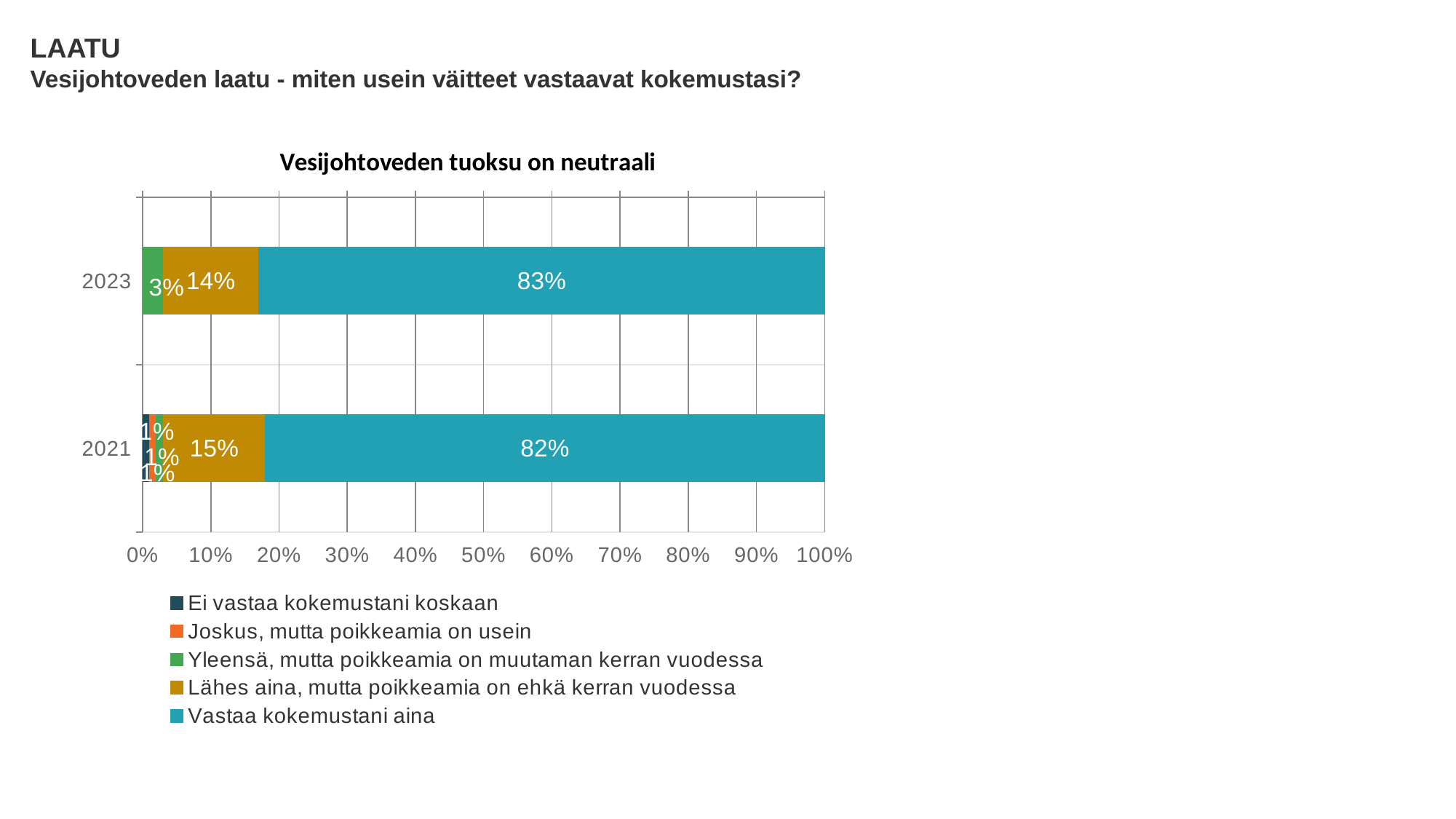
What kind of chart is shown on the slide? Stacked bar chart What is the value for "Lähes aina, mutta poikkeamia on ehkä kerran vuodessa" in 2021? 15% Which year has the larger value for "Lähes aina, mutta poikkeamia on ehkä kerran vuodessa", 2023 or 2021? 2021 How many categories (years) are shown on the chart? 2 What is the value for "Yleensä, mutta poikkeamia on muutaman kerran vuodessa" in 2023? 3% What is the title of the chart? Vesijohtoveden tuoksu on neutraali What is the value for "Vastaa kokemustani aina" in 2021? 82% Which series has the highest value in 2023? Vastaa kokemustani aina What is the value for "Vastaa kokemustani aina" in 2023? 83% What is the difference between the "Vastaa kokemustani aina" values for 2023 and 2021? 1% What is the value for "Lähes aina, mutta poikkeamia on ehkä kerran vuodessa" in 2023? 14% How many series does the legend list? 5